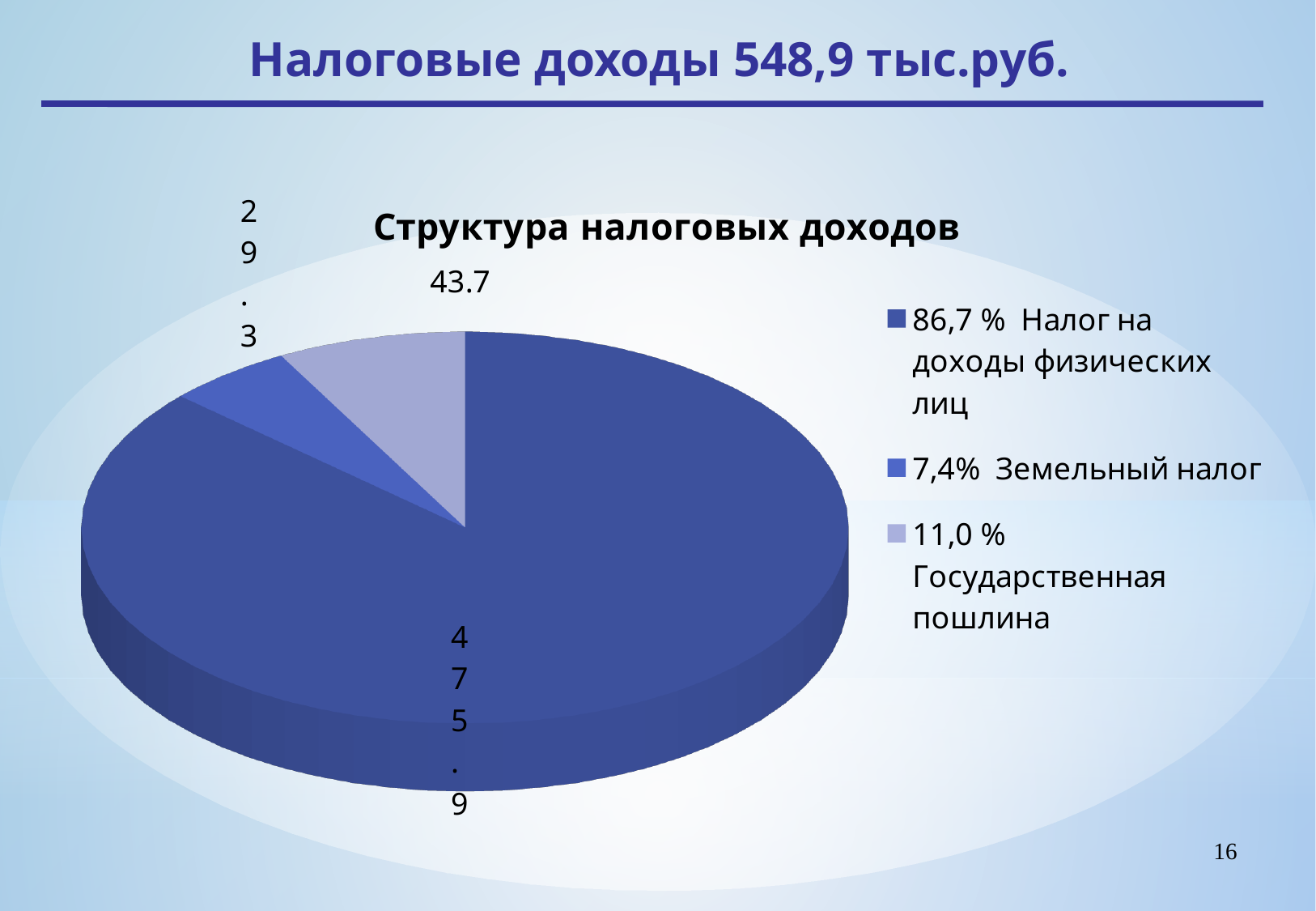
What is the value shown for Земельный налог in the pie chart? 29.3 What is the difference between the values for Государственная пошлина and Земельный налог? 14.4 Which category has the smallest slice in the pie chart? Земельный налог What is the value shown for Налог на доходы физических лиц in the pie chart? 475.9 Which is larger: the slice for Государственная пошлина or the slice for Земельный налог? Государственная пошлина How many slices does the pie chart have? 3 According to the legend, what share of tax revenues does Земельный налог make up? 7,4% What is the value shown for Государственная пошлина in the pie chart? 43.7 What is the title of the chart? Структура налоговых доходов Which category has the largest slice in the pie chart? Налог на доходы физических лиц What is the difference between the values for Налог на доходы физических лиц and Государственная пошлина? 432.2 What kind of chart is shown on the slide? Pie chart